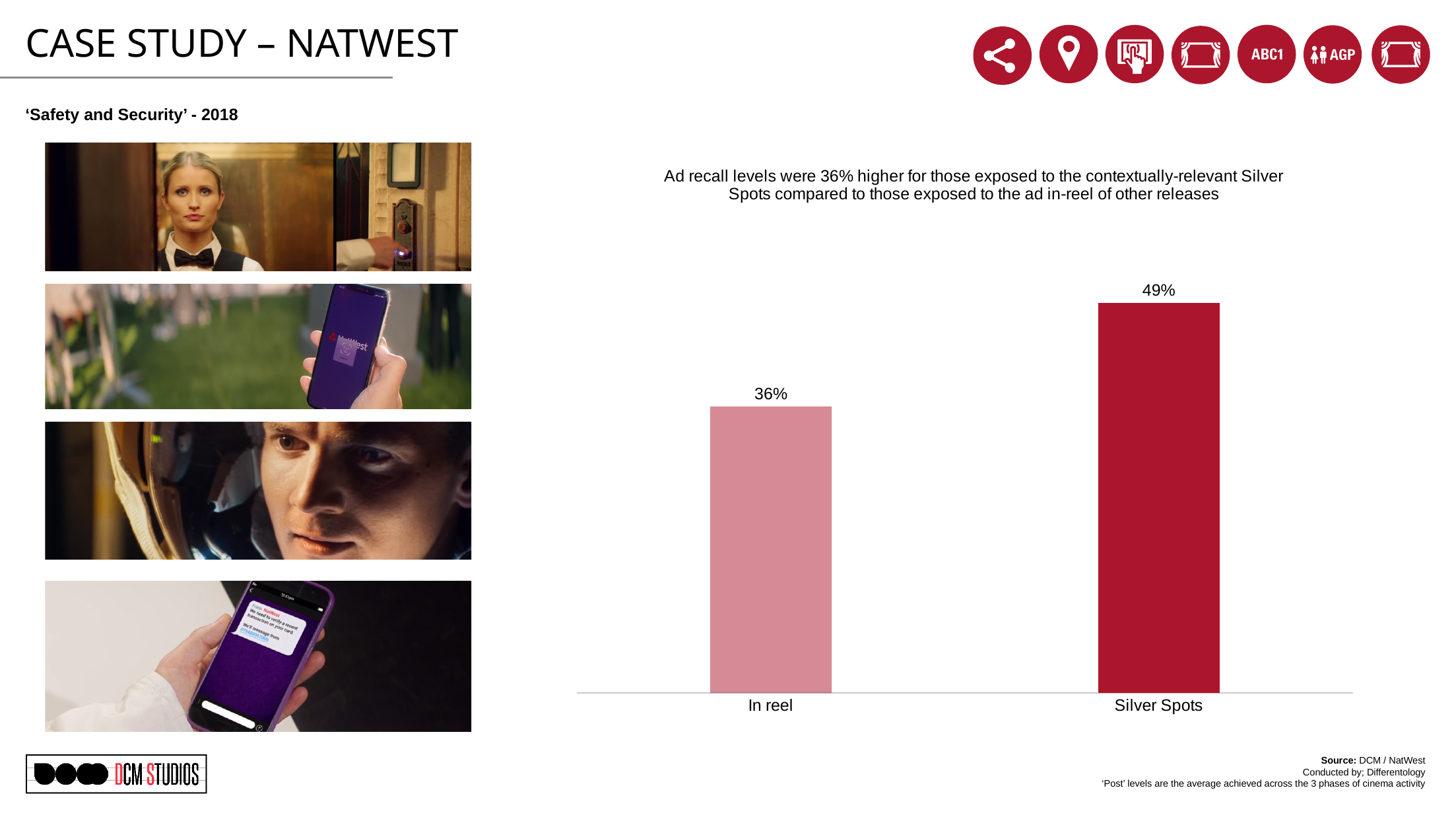
Do the values rise or fall from In reel to Silver Spots? Rise Which category has the highest ad recall value? Silver Spots Which category has the lowest ad recall value? In reel Which is larger, the value for In reel or the value for Silver Spots? Silver Spots What is the difference in ad recall between Silver Spots and In reel? 13% Which bar is coloured dark red? Silver Spots What is the ad recall value for In reel? 36% What is the ad recall value for Silver Spots? 49% What kind of chart is shown on the slide? Bar chart How many categories are shown in the chart? 2 What is the label of the bar on the right of the chart? Silver Spots